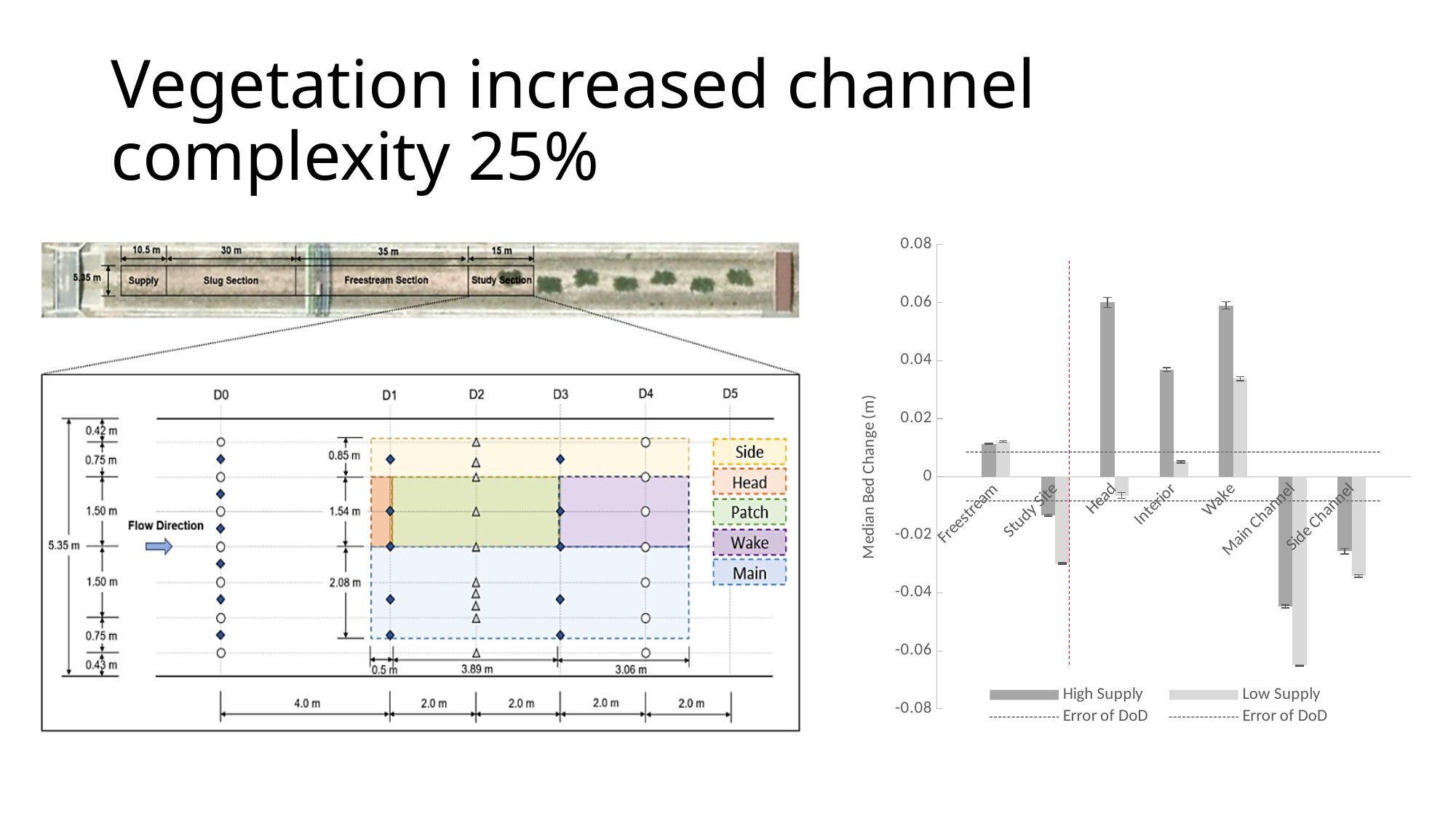
Is the High Supply value for Head greater or less than 0.04? greater What kind of chart is shown on the right side of the slide? bar chart Which category has the lowest Low Supply value in the bar chart? Main Channel What is the label of the vertical axis of the bar chart? Median Bed Change (m) How many categories are shown on the x axis of the bar chart? 7 How many entries does the legend of the bar chart list? 4 Is the Low Supply value for Main Channel greater or less than -0.06? less Which category has the highest Low Supply value in the bar chart? Wake Is the High Supply value for Interior greater or less than 0.02? greater For Interior, which series has the higher value, High Supply or Low Supply? High Supply Which category has the lowest High Supply value in the bar chart? Main Channel For Wake, which series has the higher value, High Supply or Low Supply? High Supply